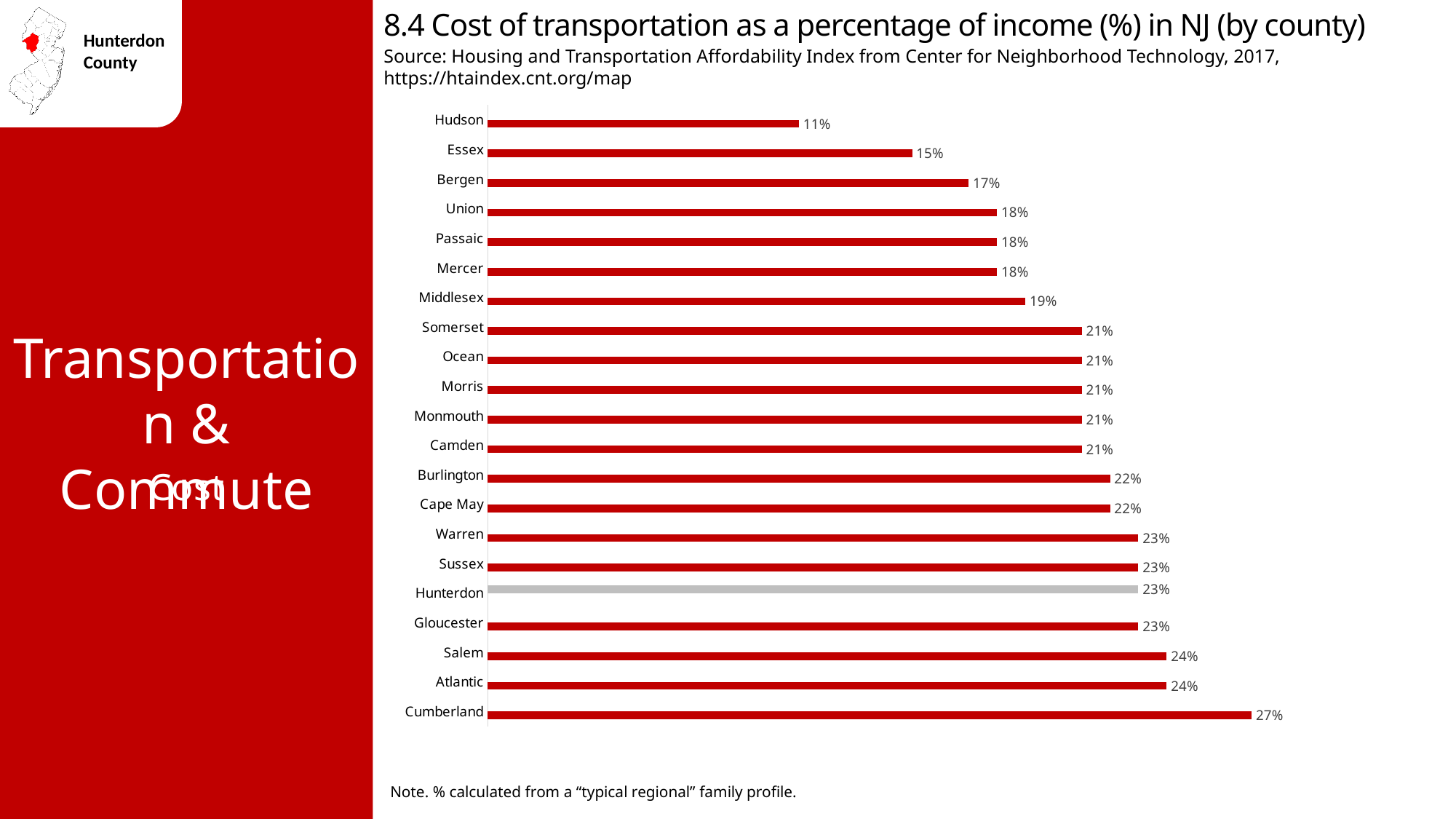
Which county has a higher cost of transportation as a percentage of income, Bergen or Salem? Salem What type of chart is used on this slide? Bar chart Which county has the highest cost of transportation as a percentage of income? Cumberland Which county's bar is shown in grey instead of red? Hunterdon What is the cost of transportation as a percentage of income for Middlesex County? 19% How many counties are shown in the chart? 21 What is the cost of transportation as a percentage of income for Hudson County? 11% What is the cost of transportation as a percentage of income for Hunterdon County? 23% Which county has the lowest cost of transportation as a percentage of income? Hudson What is the difference in percentage points between Hunterdon and Essex? 8 What is the value for Cape May County? 22% What is the difference in percentage points between Cumberland and Hudson? 16